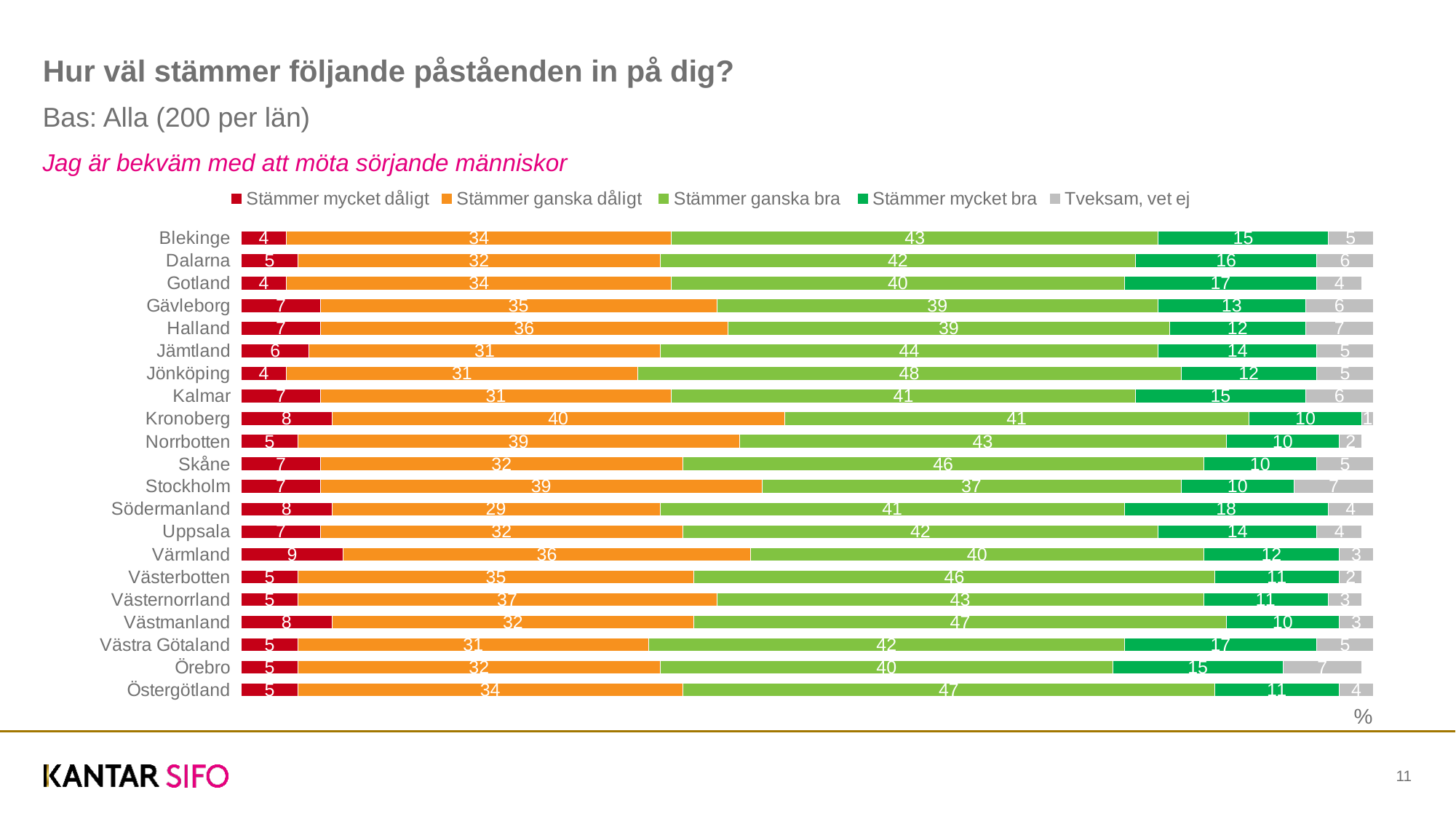
What is the statement shown in pink above the chart? Jag är bekväm med att möta sörjande människor What kind of chart is shown on the slide? Stacked bar chart How many counties are shown in the chart? 21 Which county has the highest value for "Stämmer ganska bra"? Jönköping What is the value for "Stämmer ganska dåligt" for Kronoberg? 40 Which county has the highest value for "Stämmer mycket dåligt"? Värmland Which county has the lowest value for "Stämmer ganska dåligt"? Södermanland What is the value for "Stämmer mycket bra" for Södermanland? 18 What is the difference between the "Stämmer mycket bra" values for Gotland and Stockholm? 7 Which is larger: the "Stämmer ganska bra" value for Skåne or for Halland? Skåne What is the value for "Stämmer ganska bra" for Jönköping? 48 How many series does the legend list? 5